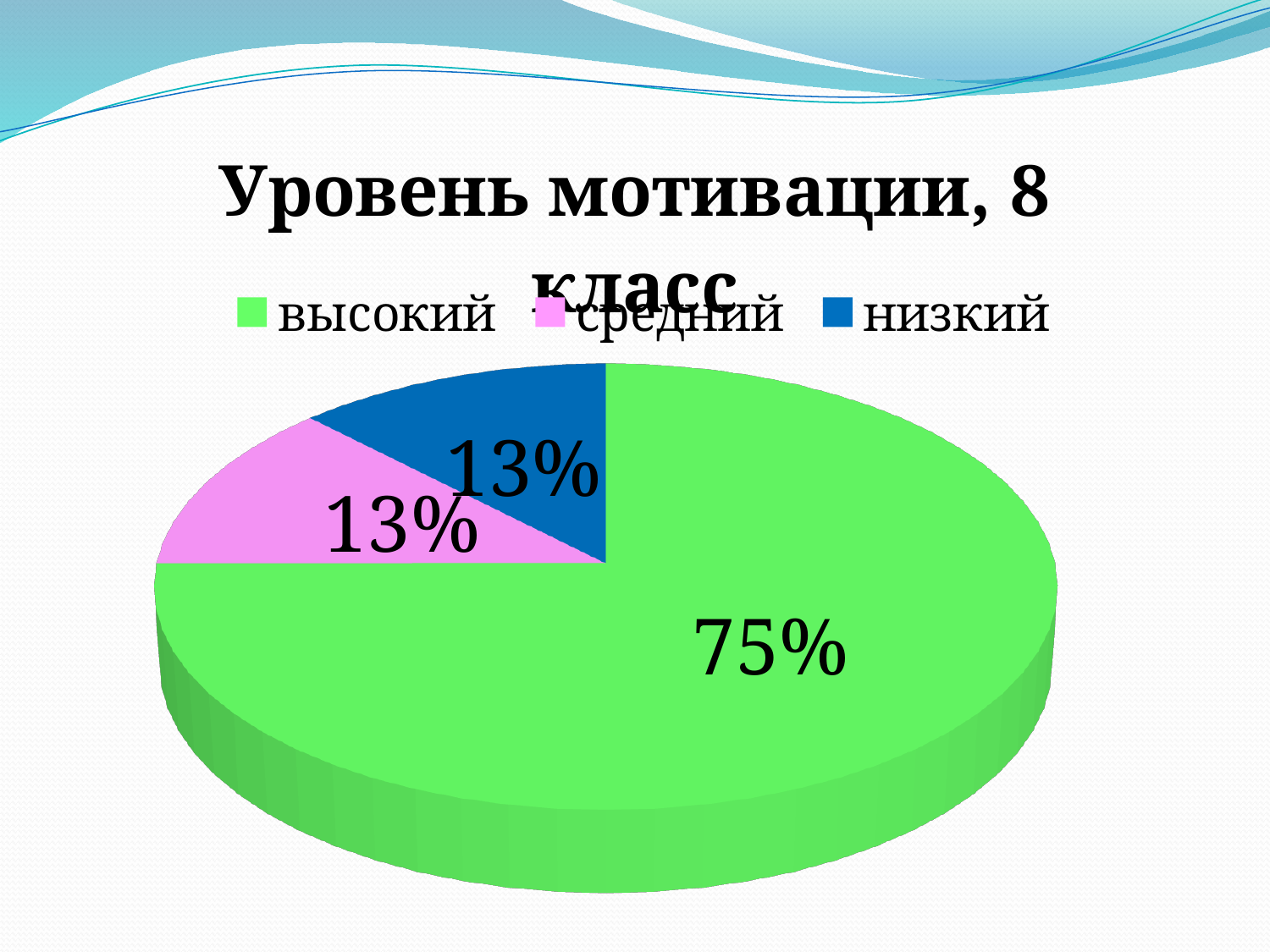
What is the title of the chart? Уровень мотивации, 8 класс How many slices does the pie chart have? 3 What colour represents the низкий category in the chart? blue What value is shown for the средний slice? 13% What share of the pie does the высокий category have? 75% Which is larger, the высокий slice or the низкий slice? высокий Which category has the largest slice of the pie? высокий What value is shown for the низкий slice? 13% How many entries does the legend list? 3 What kind of chart is shown on the slide? pie chart What is the difference in percentage points between the высокий and средний slices? 62